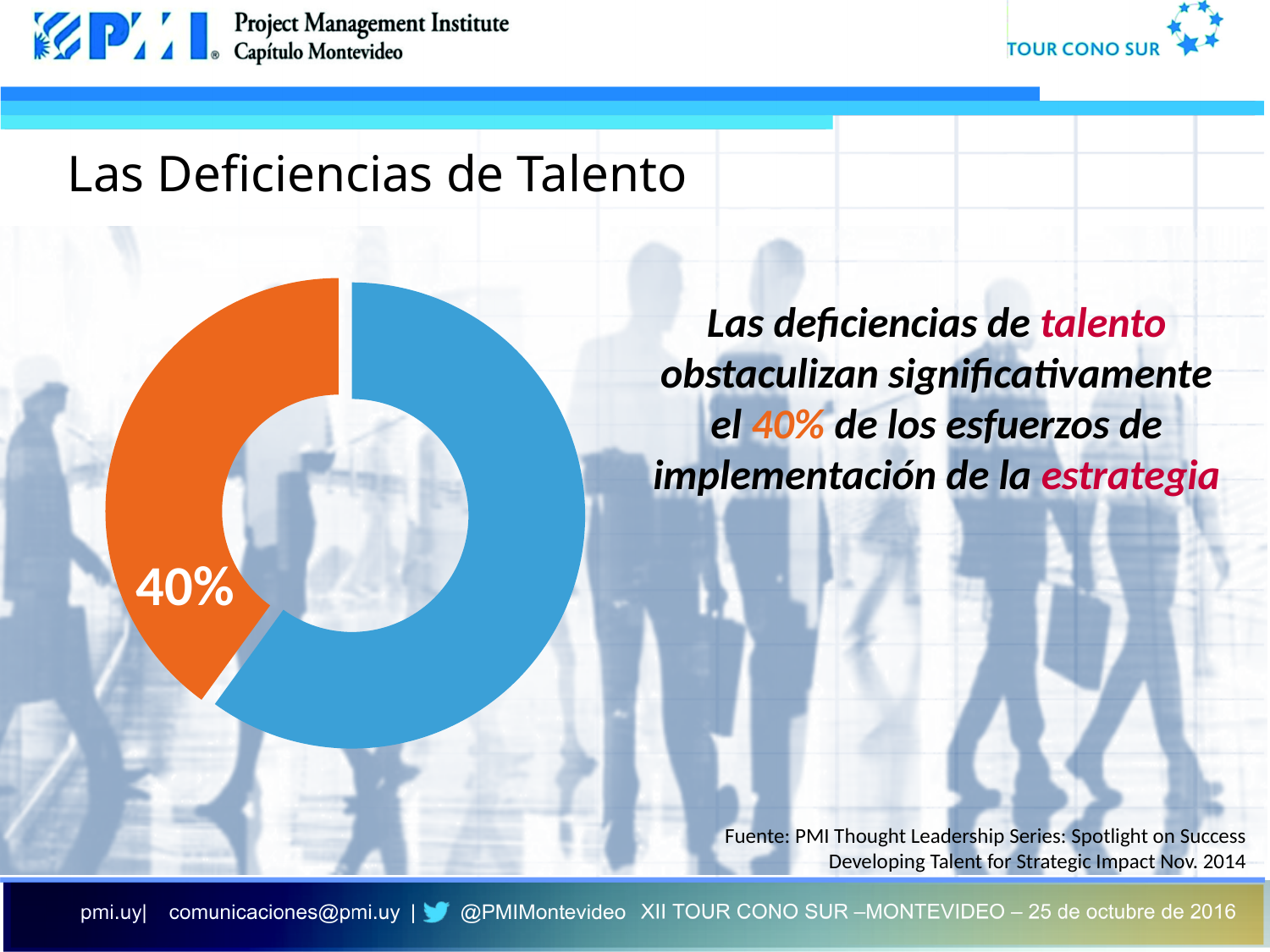
What kind of chart is shown on the slide? Pie chart (donut) What is the title of the slide containing the chart? Las Deficiencias de Talento What colour is the slice labelled 40% in the donut chart? Orange Which slice of the donut chart is larger, the orange one or the blue one? The blue one How many slices does the donut chart have? 2 What share of the donut chart does the orange slice represent? 40% Which slice of the donut chart is the smallest? The orange slice (40%) What value is printed on the orange slice of the donut chart? 40%